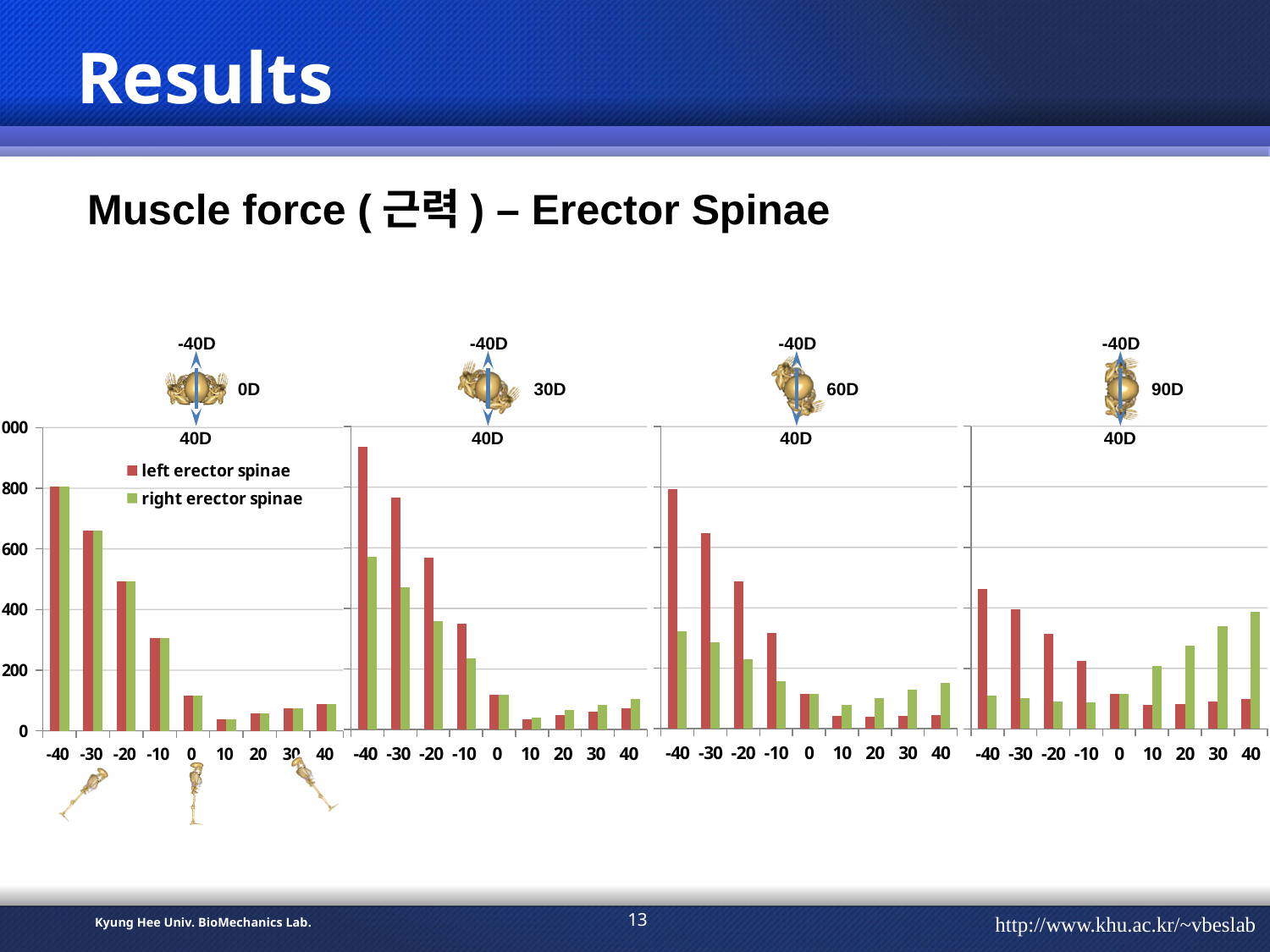
In the 90D chart, which x-axis category has the highest right erector spinae value? 40 What kind of chart is used in the 0D panel? bar chart In the 0D chart, is the left erector spinae value at -40 greater or less than 600? greater In the 60D chart, is the right erector spinae value at -40 greater or less than 400? less How many x-axis categories does the 30D chart have? 9 In the 0D chart, which x-axis category has the highest left erector spinae value? -40 What colour are the left erector spinae bars in the charts? red In the 30D chart, at -40, which series is larger: left erector spinae or right erector spinae? left erector spinae How many series does the legend in the 0D chart list? 2 In the 60D chart, at 40, which series is larger: left erector spinae or right erector spinae? right erector spinae In the 90D chart, do the right erector spinae values rise or fall from 0 to 40 along the x axis? rise In the 30D chart, is the left erector spinae value at -40 greater or less than 800? greater